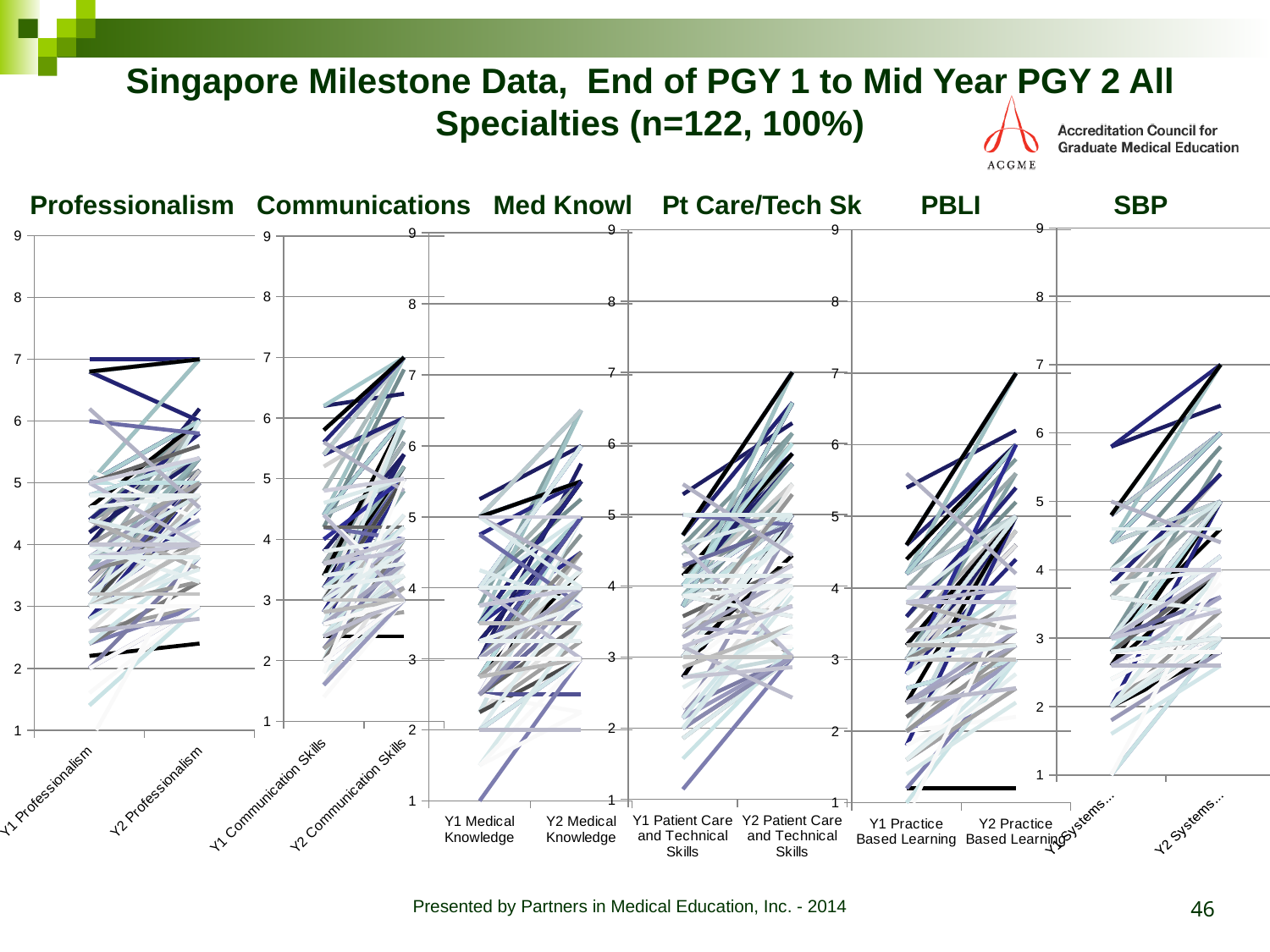
In the PBLI chart, is the lowest value at Y1 Practice Based Learning greater or less than 2? less In the Professionalism chart, do the values generally rise or fall from Y1 to Y2? rise In the Med Knowl chart, is the highest value at Y1 Medical Knowledge greater or less than 6? less In the Pt Care/Tech Sk chart, do the values generally rise or fall from Y1 to Y2? rise According to the slide title, what is the sample size n for the Singapore milestone data? 122 How many separate charts are shown on the slide? 6 What kind of chart is the Professionalism chart? line chart How many categories are on the x axis of the Communications chart? 2 In the SBP chart, is the highest value at Y2 Systems greater or less than 6? greater What is the highest tick value shown on the y axis of the PBLI chart? 9